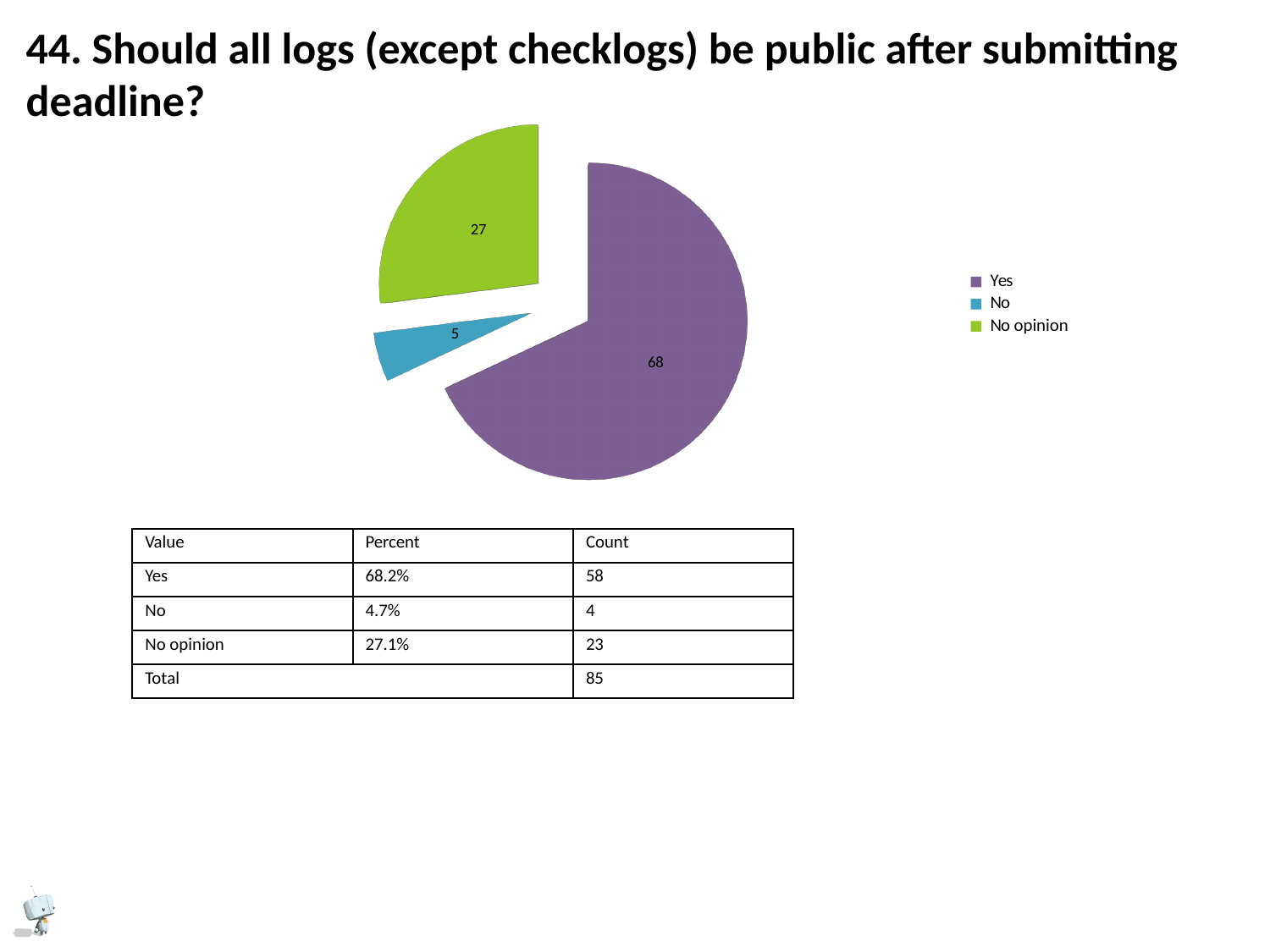
What is the difference between the No opinion and No data labels in the pie chart? 22 What is the difference between the Yes and No opinion data labels in the pie chart? 41 How many slices does the pie chart have? 3 What colour is the Yes slice in the pie chart? purple What type of chart is shown on the slide? pie chart Which category has the smallest slice in the pie chart? No Which category has the largest slice in the pie chart? Yes How many entries does the legend of the pie chart list? 3 What is the data label on the No opinion slice of the pie chart? 27 What is the data label on the Yes slice of the pie chart? 68 What is the data label on the No slice of the pie chart? 5 Which slice is larger in the pie chart, No or No opinion? No opinion